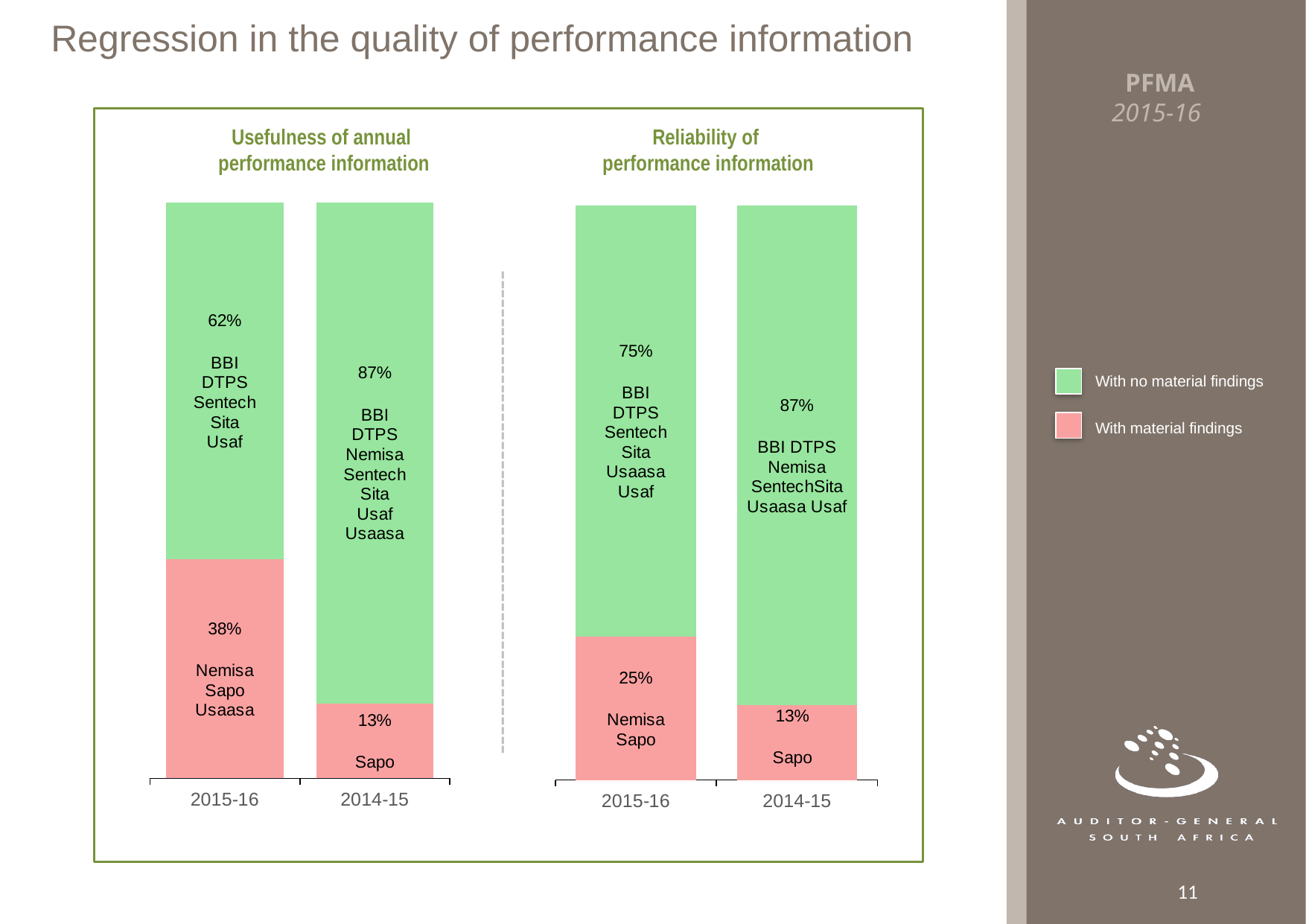
In the 'Reliability of performance information' chart, what percentage had no material findings in 2014-15? 87% In the 'Usefulness of annual performance information' chart, what percentage had material findings in 2014-15? 13% What type of chart is used for 'Usefulness of annual performance information'? Stacked bar chart How many series does the legend list? 2 In the 'Usefulness of annual performance information' chart, what percentage had no material findings in 2015-16? 62% In the 'Reliability of performance information' chart, what is the difference between the 'With no material findings' shares for 2014-15 and 2015-16? 12 percentage points In the 'Reliability of performance information' chart, what percentage had material findings in 2015-16? 25% In the 'Usefulness of annual performance information' chart, which year has the higher share with material findings? 2015-16 In the 'Reliability of performance information' chart, which year has the lower share with no material findings? 2015-16 In the 'Usefulness of annual performance information' chart, by how many percentage points did the share with material findings change from 2014-15 to 2015-16? 25 percentage points How many year categories are shown in the 'Reliability of performance information' chart? 2 Which colour represents 'With material findings' in the legend? Red (pink)